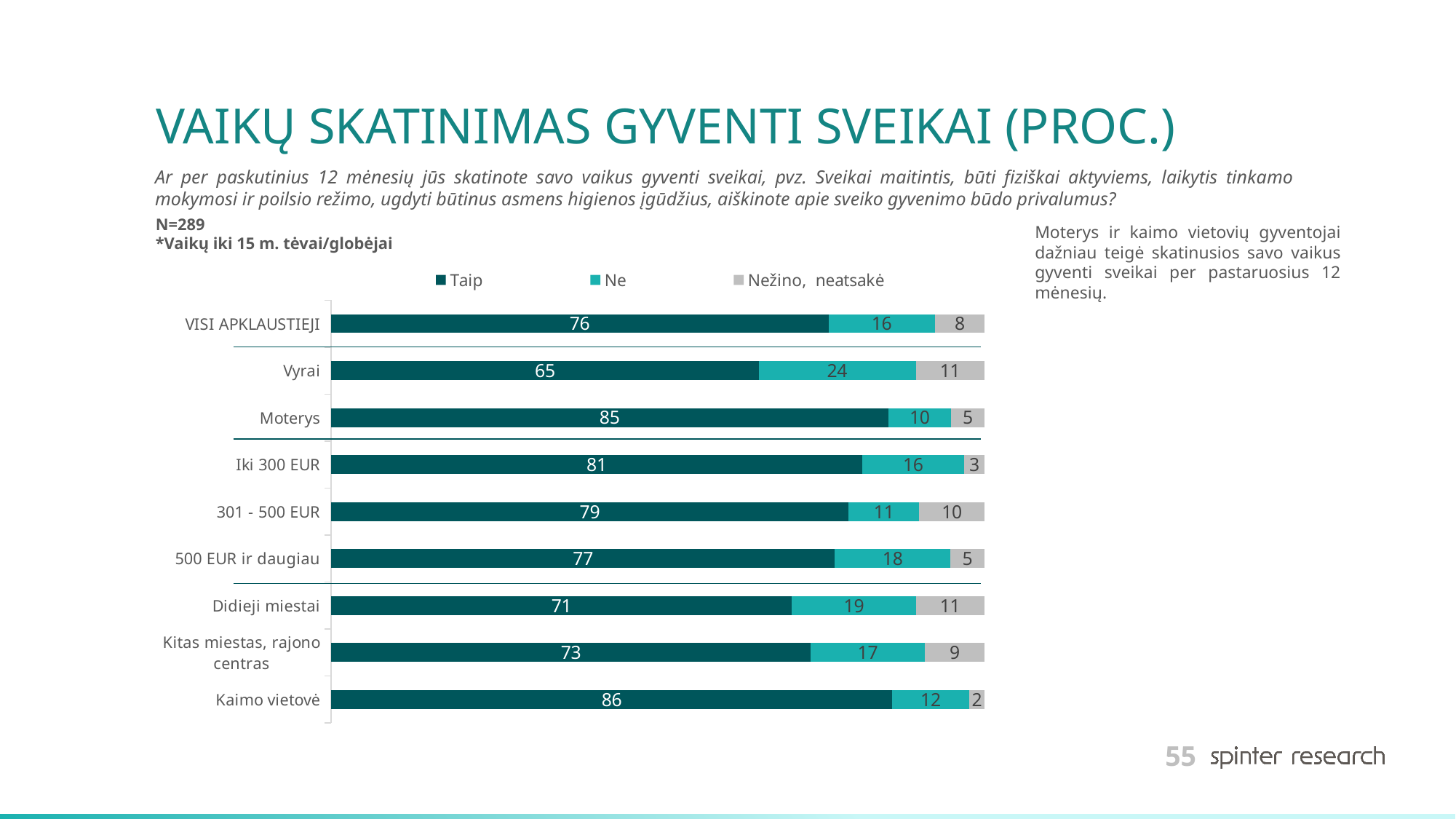
What is the sample size (N) stated on the slide? N=289 Which category has the lowest "Taip" value? Vyrai What kind of chart is shown on the slide? Stacked bar chart How many series does the legend list? 3 What is the difference between the "Taip" values for Moterys and Vyrai? 20 Which has a larger "Ne" value, Didieji miestai or Kaimo vietovė? Didieji miestai What is the "Ne" value for Vyrai? 24 What is the "Taip" value for Moterys? 85 Which category has the highest "Taip" value? Kaimo vietovė What is the total of the stacked bar for Iki 300 EUR? 100 What is the "Nežino, neatsakė" value for 301 - 500 EUR? 10 How many categories are shown on the chart? 9